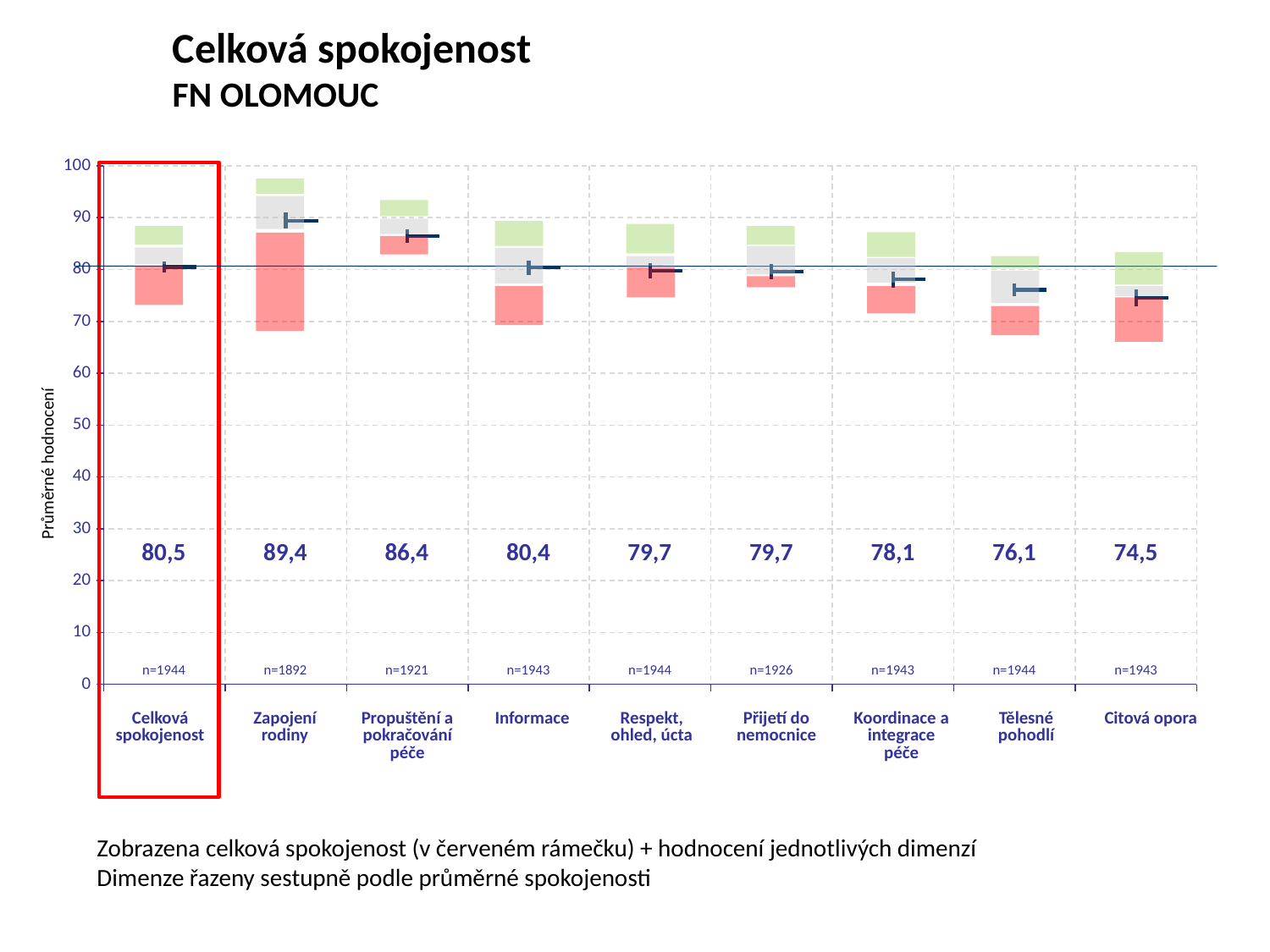
What is the label of the y axis? Průměrné hodnocení What is the difference between the ratings for Propuštění a pokračování péče and Informace? 6,0 Which dimension has the highest average rating? Zapojení rodiny Which dimension has the lowest average rating? Citová opora Which category is highlighted with a red frame? Celková spokojenost What value is printed for Celková spokojenost? 80,5 What is the average rating shown for Zapojení rodiny? 89,4 How many categories are shown along the x axis? 9 Which has a higher average rating, Koordinace a integrace péče or Tělesné pohodlí? Koordinace a integrace péče What is the average rating shown for Citová opora? 74,5 What is the sample size (n) shown for Zapojení rodiny? n=1892 What is the difference between the average ratings for Zapojení rodiny and Citová opora? 14,9